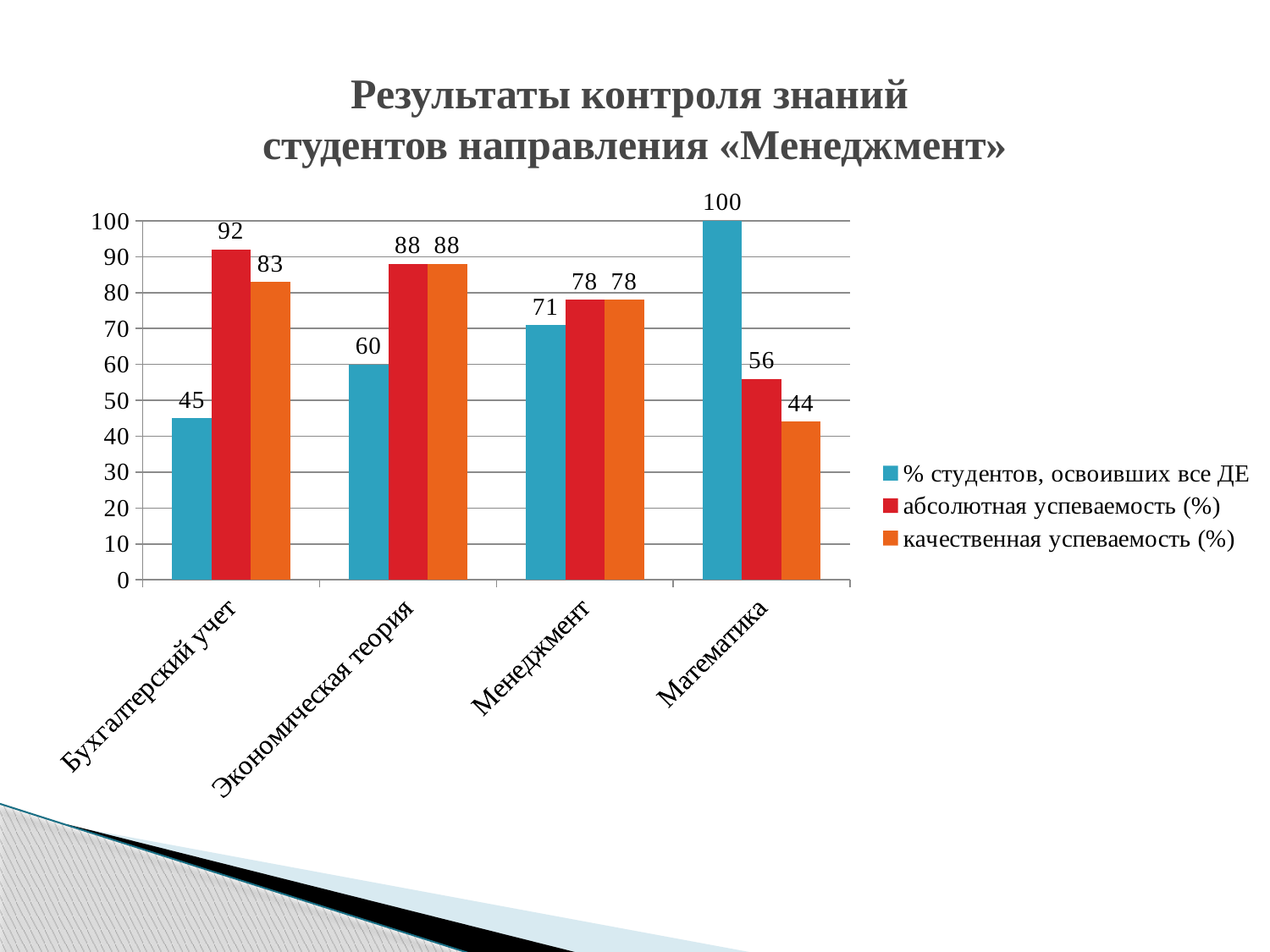
How many categories are shown on the x axis? 4 What is the value of "качественная успеваемость (%)" for Экономическая теория? 88 Which is larger for Менеджмент: "% студентов, освоивших все ДЕ" or "абсолютная успеваемость (%)"? абсолютная успеваемость (%) Which series is shown in orange in the legend? качественная успеваемость (%) Does the value of "% студентов, освоивших все ДЕ" rise or fall across the categories from left to right? Rises What kind of chart is shown on the slide? Bar chart What is the value of "абсолютная успеваемость (%)" for Математика? 56 What is the difference between "абсолютная успеваемость (%)" and "качественная успеваемость (%)" for Бухгалтерский учет? 9 Which category has the highest value for "% студентов, освоивших все ДЕ"? Математика How many series does the legend list? 3 Which category has the lowest value for "качественная успеваемость (%)"? Математика What is the value of "% студентов, освоивших все ДЕ" for Бухгалтерский учет? 45